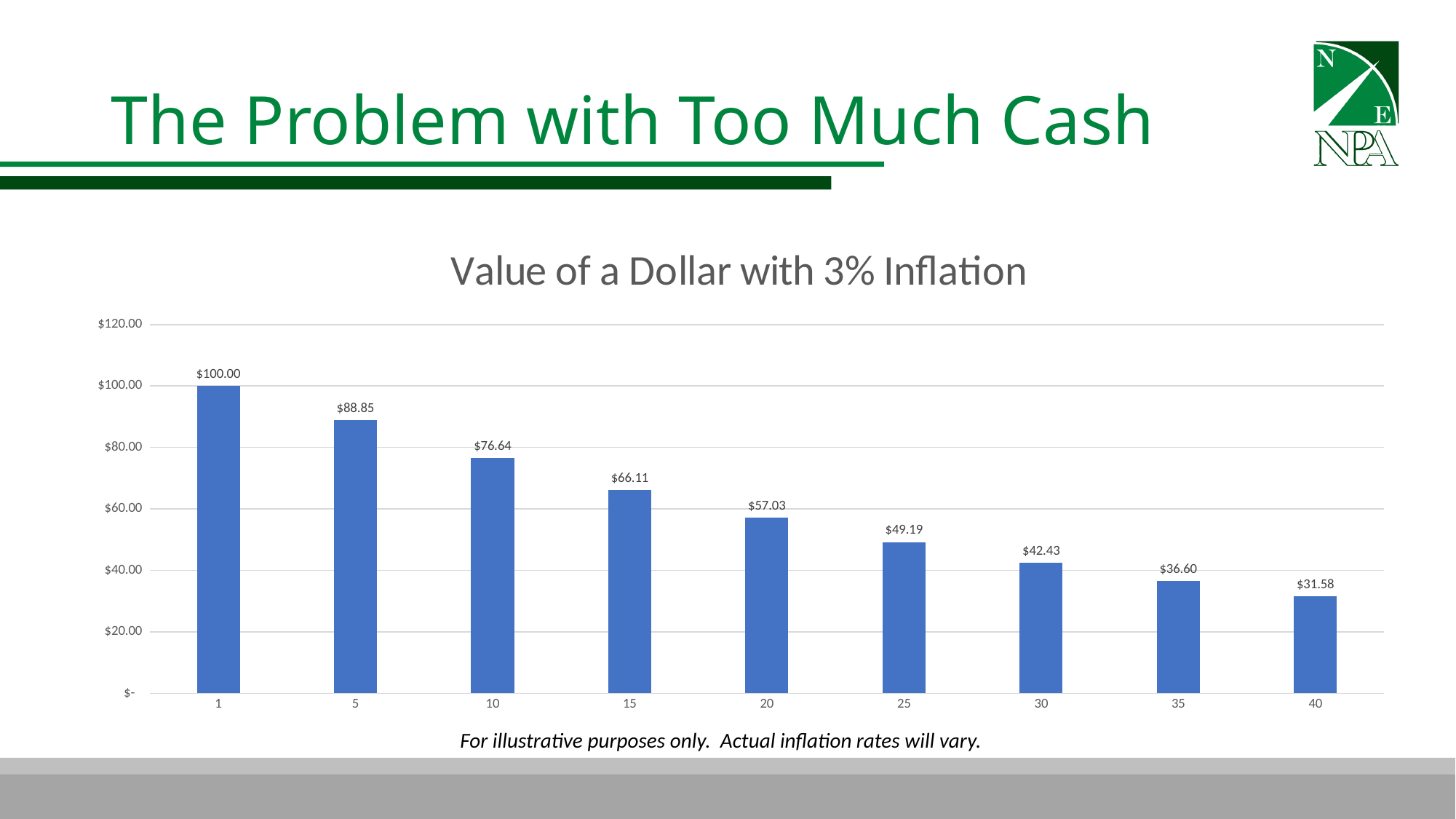
What is the value shown for year 25? $49.19 Which is larger, the value for year 30 or the value for year 35? year 30 Do the values rise or fall as the years increase along the x axis? fall Which year has the lowest value? 40 What kind of chart is shown on the slide? bar chart What is the value shown for year 10? $76.64 Which year has the highest value? 1 What is the value shown for year 40? $31.58 Is the value for year 15 greater or less than $60.00? greater What is the difference between the values for year 5 and year 15? $22.74 What is the difference between the values for year 1 and year 20? $42.97 How many bars are plotted in the chart? 9